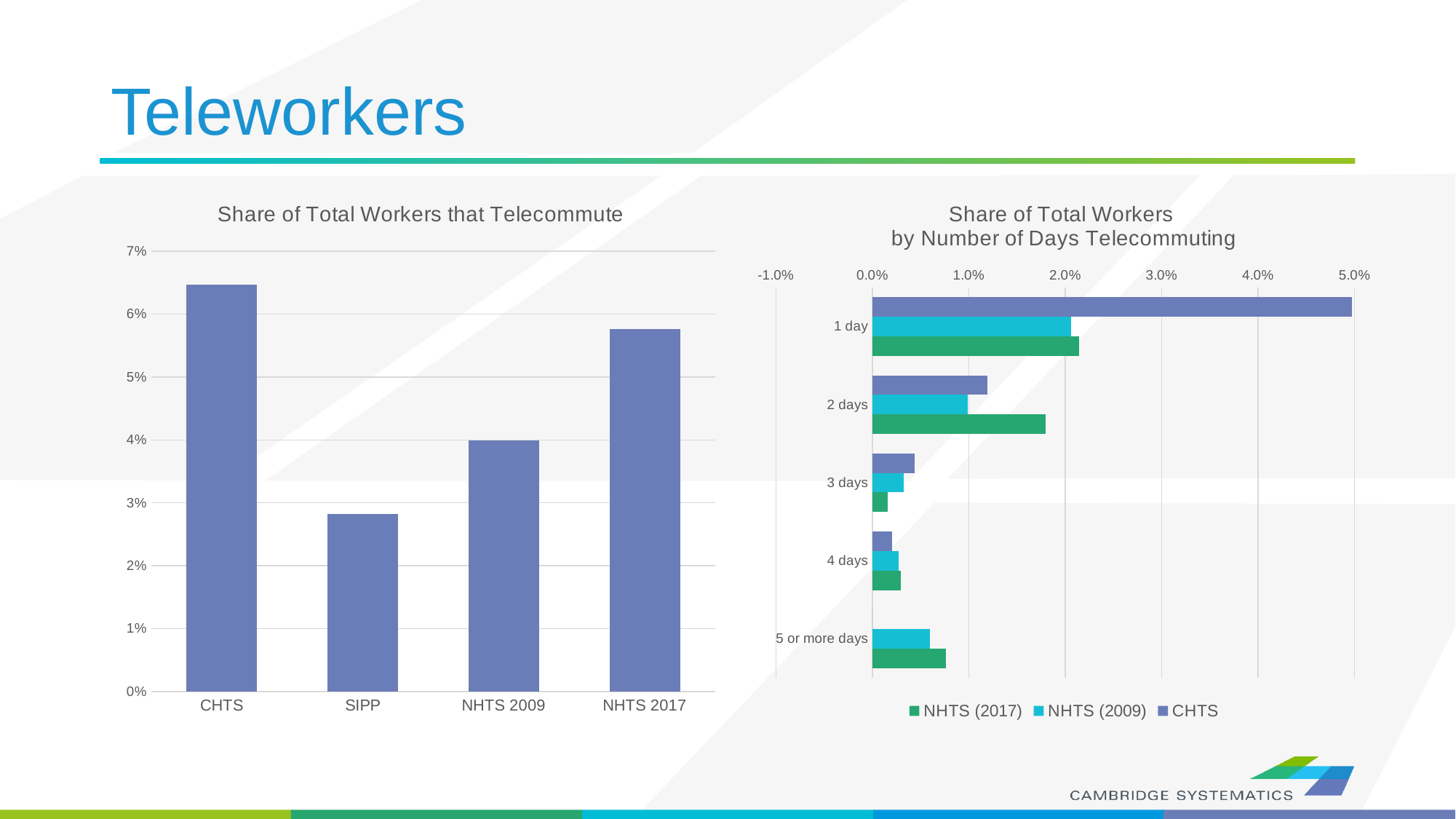
In the "Share of Total Workers that Telecommute" chart, is the value for NHTS 2017 greater or less than 5%? greater In the "Share of Total Workers that Telecommute" chart, how many categories are shown on the x axis? 4 In the "Share of Total Workers by Number of Days Telecommuting" chart, which series has the longest bar for 2 days? NHTS (2017) In the "Share of Total Workers that Telecommute" chart, which is larger, NHTS 2009 or NHTS 2017? NHTS 2017 In the "Share of Total Workers by Number of Days Telecommuting" chart, which series has the longest bar for 1 day? CHTS In the "Share of Total Workers that Telecommute" chart, which category has the lowest value? SIPP How many series does the legend of the "Share of Total Workers by Number of Days Telecommuting" chart list? 3 In the "Share of Total Workers that Telecommute" chart, is the value for SIPP greater or less than 3%? less In the "Share of Total Workers by Number of Days Telecommuting" chart, is the CHTS value for 1 day greater or less than 4.0%? greater What kind of chart is "Share of Total Workers that Telecommute"? bar chart In the "Share of Total Workers that Telecommute" chart, which category has the highest value? CHTS In the "Share of Total Workers by Number of Days Telecommuting" chart, how many day categories are listed on the vertical axis? 5